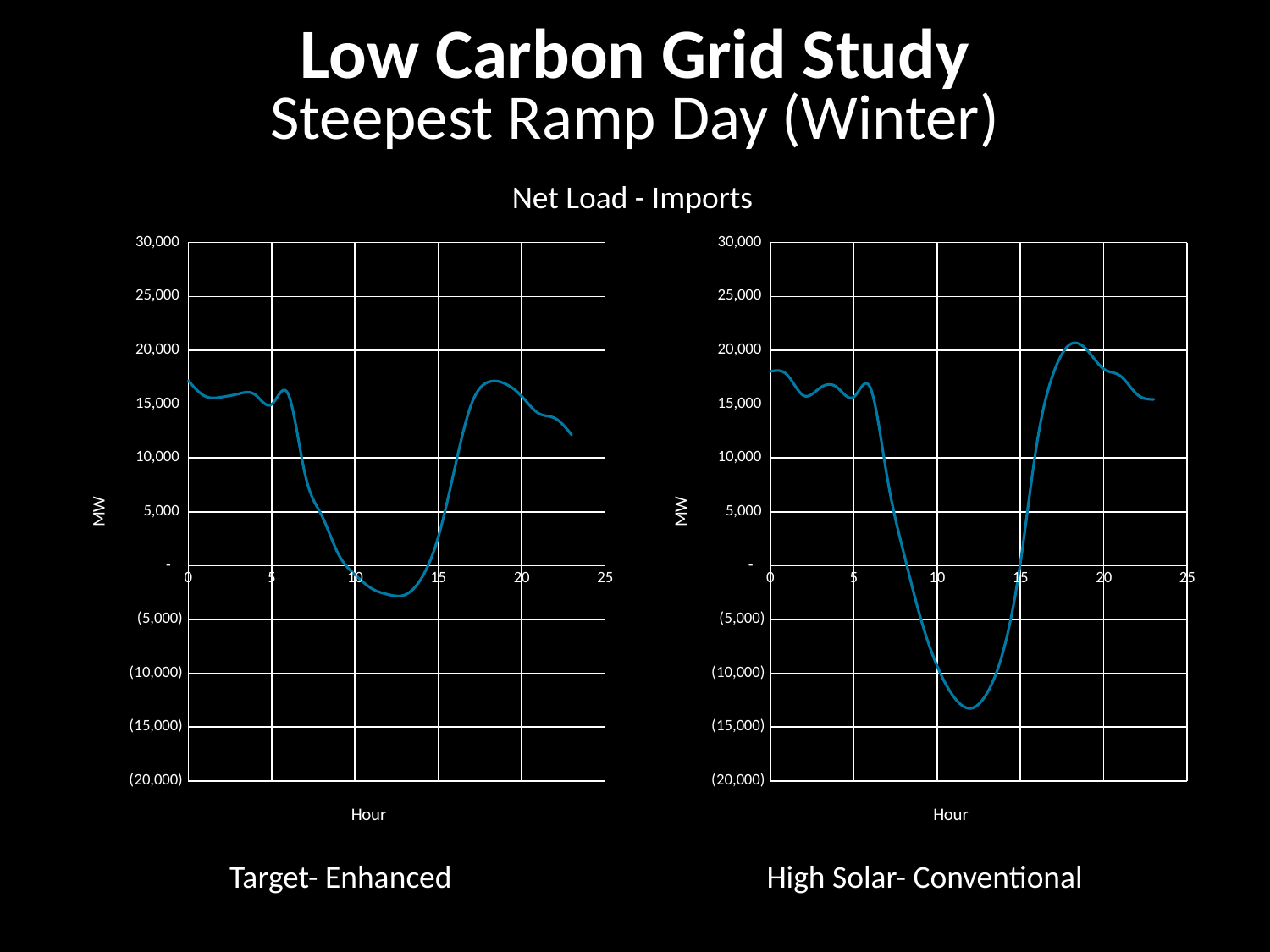
In the High Solar- Conventional chart, is the value at hour 18 greater or less than 15,000? greater In the Target- Enhanced chart, is the value at hour 12 greater or less than 0? less In the Target- Enhanced chart, is the value at hour 0 greater or less than 15,000? greater What kind of chart is the Target- Enhanced chart on the left? line chart In the Target- Enhanced chart, do the values rise or fall between hour 6 and hour 12? fall Which chart reaches the lower minimum value, Target- Enhanced or High Solar- Conventional? High Solar- Conventional What is the title of the vertical axis on both charts? MW In the High Solar- Conventional chart, do the values rise or fall between hour 12 and hour 18? rise What is the shared title shown above the two charts? Net Load - Imports Which chart reaches the higher peak after hour 15, Target- Enhanced or High Solar- Conventional? High Solar- Conventional